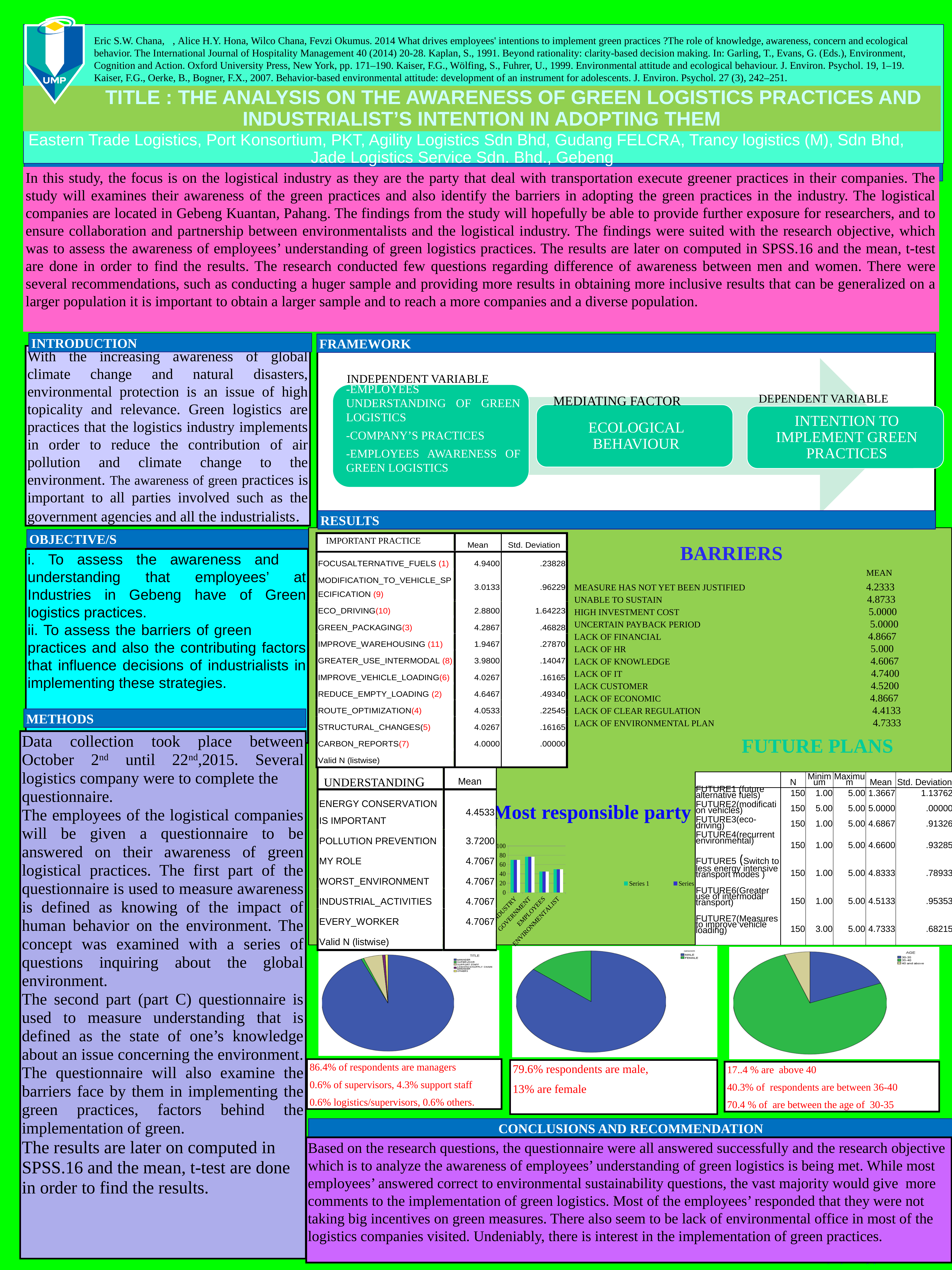
In the 'Most responsible party' bar chart, is the value for INDUSTRY greater or less than 40? greater How many entries does the legend of the AGE pie chart list? 3 What kind of chart is the 'Most responsible party' chart? bar chart According to the caption under the TITLE pie chart, what percentage of respondents are managers? 86.4% How many categories are shown on the x axis of the 'Most responsible party' bar chart? 4 In the 'Most responsible party' bar chart, which is larger, the value for GOVERNMENT or the value for ENVIRONMENTALIST? GOVERNMENT In the TITLE pie chart (bottom left), which category has the largest slice? MANAGER In the 'Most responsible party' bar chart, is the value for GOVERNMENT greater or less than 60? greater According to the caption under the GENDER pie chart, what percentage of respondents are male? 79.6% In the 'Most responsible party' bar chart, is the value for EMPLOYEES greater or less than 60? less In the GENDER pie chart, which category has the largest slice? MALE What kind of chart is the GENDER chart at the bottom of the poster? pie chart